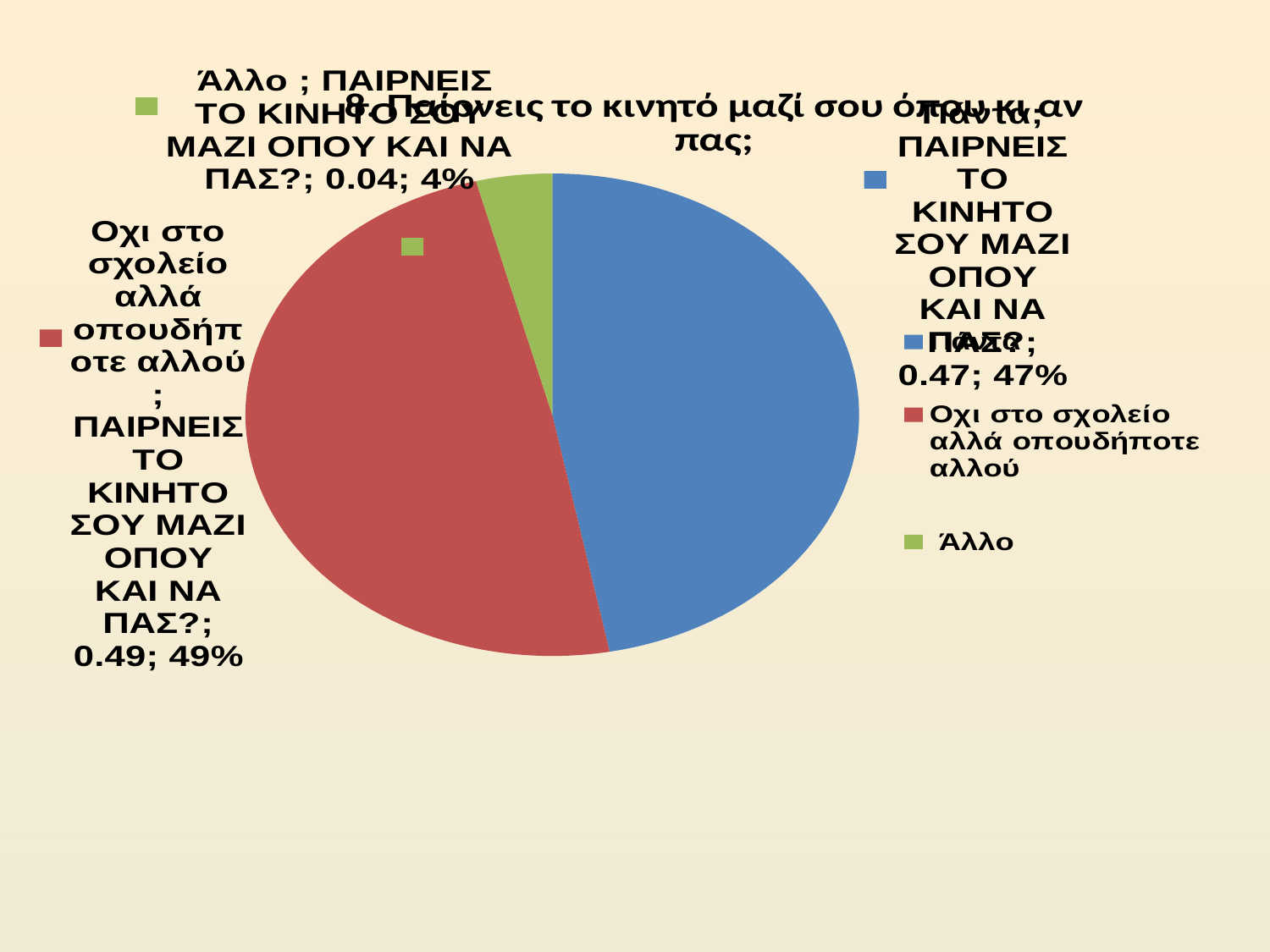
What colour is the 'Άλλο' slice? green Which category has the largest share of the pie? Όχι στο σχολείο αλλά οπουδήποτε αλλού How many slices does the pie chart have? 3 Which category has the smallest share of the pie? Άλλο What kind of chart is shown on the slide? pie chart How many entries does the legend list? 3 What percentage of the pie is the 'Πάντα' slice? 47% What percentage of the pie is the 'Όχι στο σχολείο αλλά οπουδήποτε αλλού' slice? 49% What percentage of the pie is the 'Άλλο' slice? 4% Which is larger: the 'Πάντα' slice or the 'Άλλο' slice? Πάντα What is the difference in percentage points between the 'Όχι στο σχολείο αλλά οπουδήποτε αλλού' slice and the 'Πάντα' slice? 2 percentage points What is the title of the chart? 8. Παίρνεις το κινητό μαζί σου όπου κι αν πας;